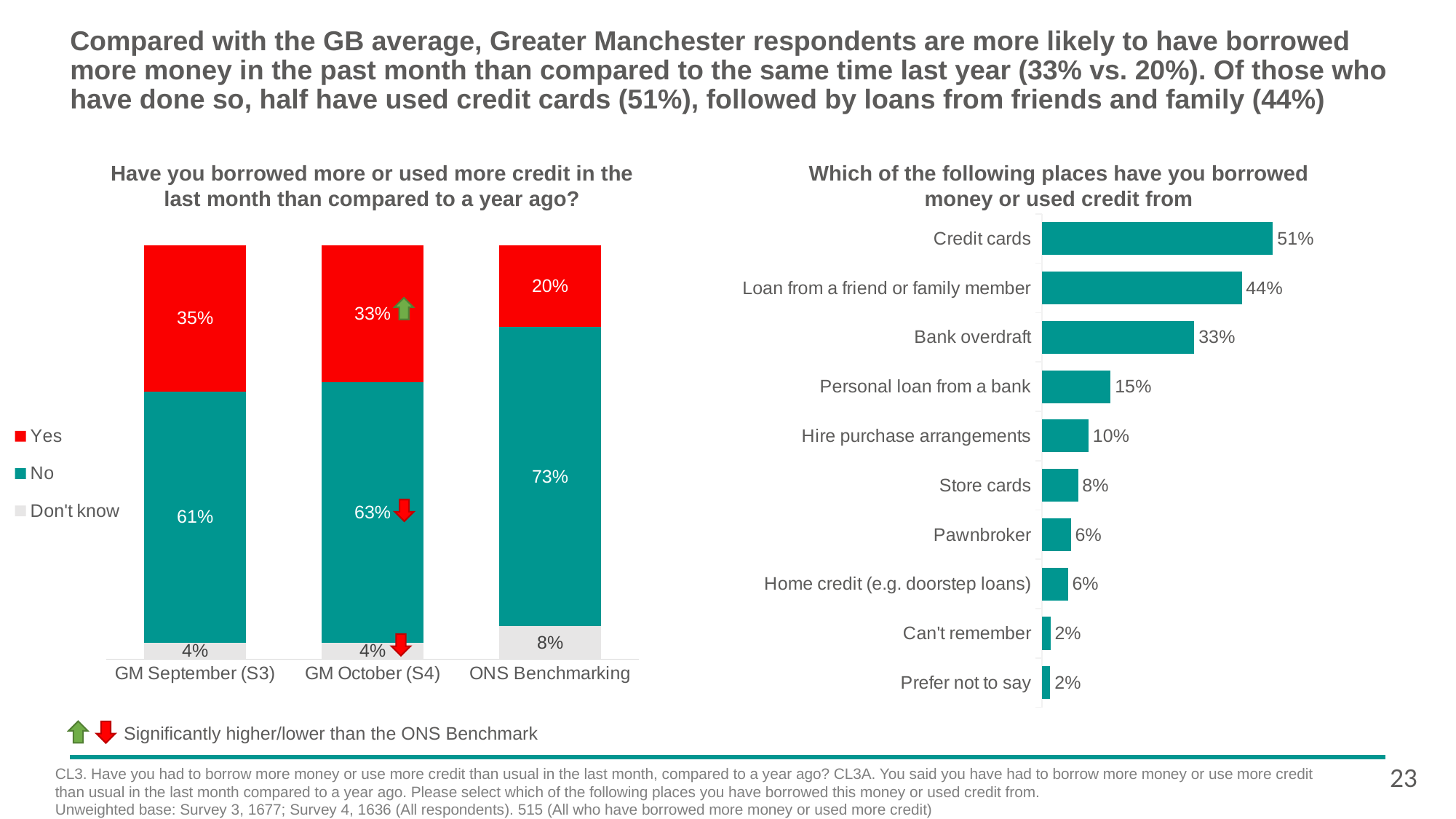
In the right chart, what is the difference between Credit cards and Loan from a friend or family member? 7 percentage points In the left chart, what is the 'Don't know' value for GM September (S3)? 4% In the right chart, how many categories are shown? 10 What kind of chart is the left chart? Stacked bar chart In the left chart 'Have you borrowed more or used more credit in the last month than compared to a year ago?', what is the 'Yes' value for GM October (S4)? 33% In the right chart 'Which of the following places have you borrowed money or used credit from', what is the value for Bank overdraft? 33% In the left chart, what is the difference between the 'Yes' values for GM September (S3) and ONS Benchmarking? 15 percentage points In the right chart, which category has the highest value? Credit cards In the left chart, what is the 'No' value for ONS Benchmarking? 73% In the left chart, which category has the highest 'Yes' value? GM September (S3) In the right chart, which is larger: Personal loan from a bank or Hire purchase arrangements? Personal loan from a bank In the left chart, how many series does the legend list? 3